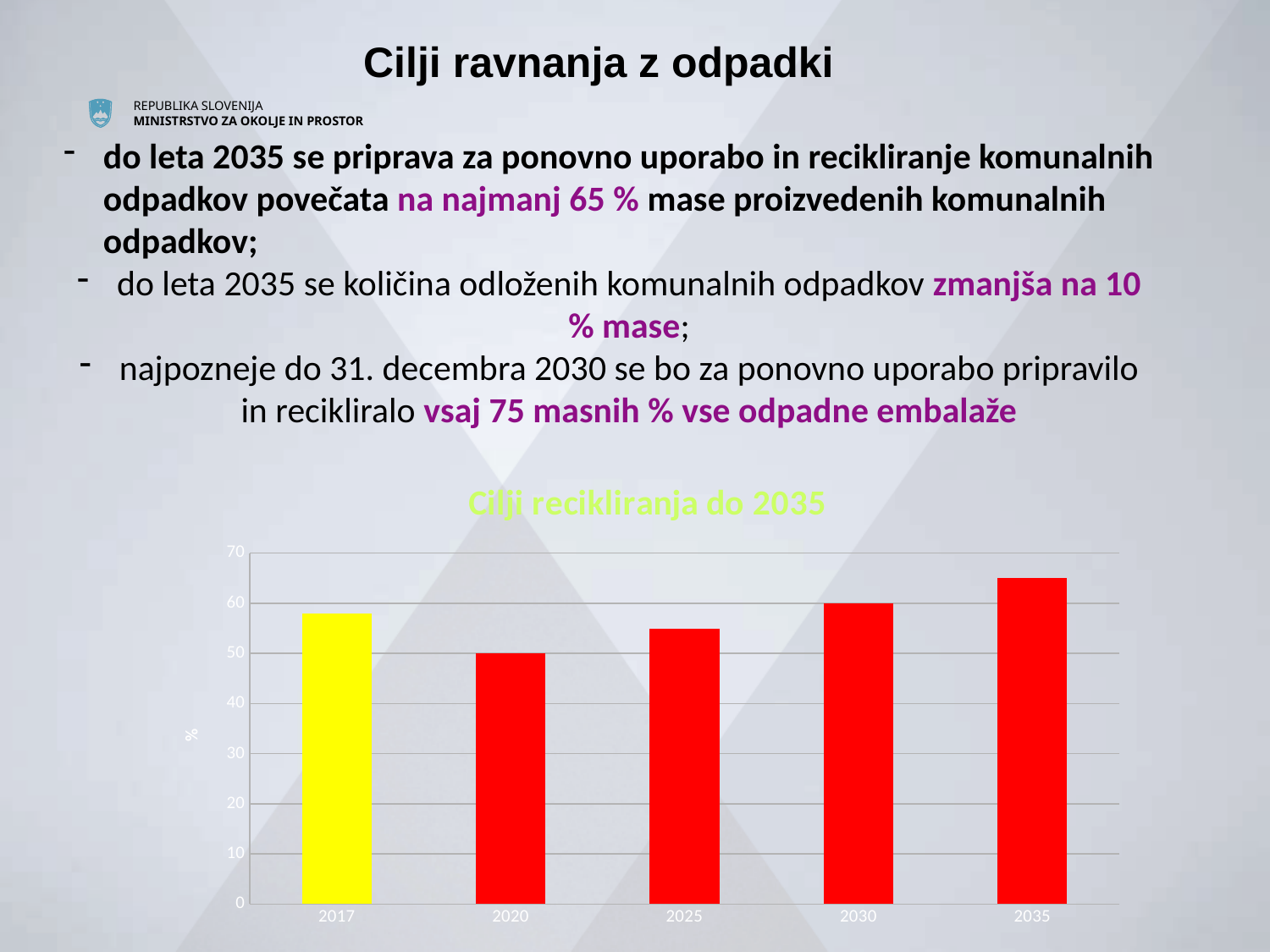
What type of chart is shown on the slide? bar chart Is the value for 2035 greater or less than 60? greater Do the values rise or fall from 2020 to 2035? rise Which year has the lowest bar in the chart? 2020 What is the title of the chart? Cilji recikliranja do 2035 How many years are shown on the x axis of the chart? 5 Which year has the highest bar in the chart? 2035 Which is larger, the value for 2017 or the value for 2020? 2017 What is the value for 2020 in the chart? 50 Is the value for 2017 greater or less than 50? greater What is the value for 2030 in the chart? 60 Is the value for 2025 greater or less than 60? less